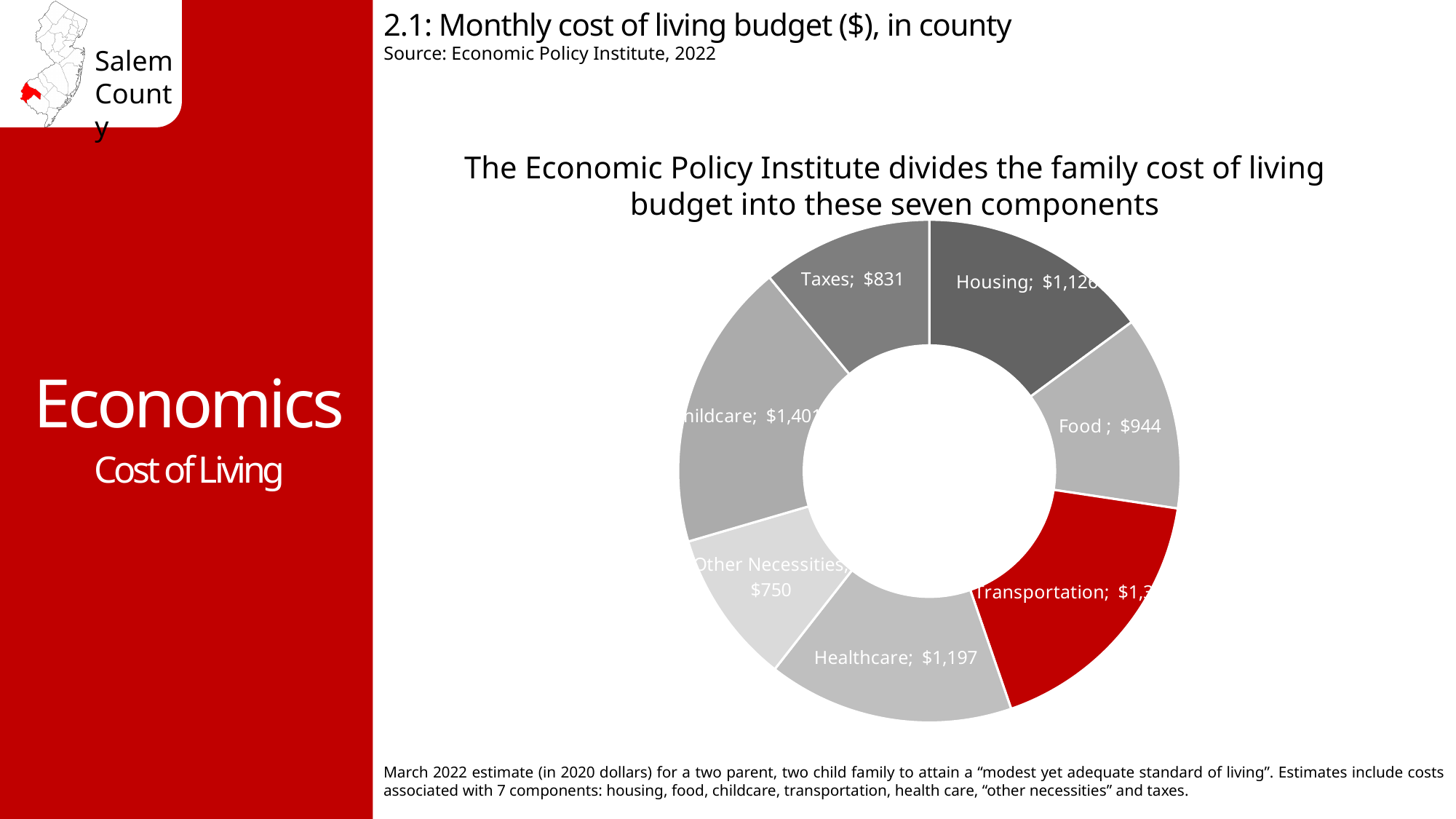
What is the difference between the Healthcare and Taxes monthly costs? $366 Which is larger, the monthly cost for Healthcare or for Food? Healthcare Which component's slice is coloured red in the chart? Transportation What is the monthly cost for Food in the chart? $944 Which is larger, the monthly cost for Taxes or for Other Necessities? Taxes What is the monthly cost for Healthcare in the chart? $1,197 What is the monthly cost for Other Necessities in the chart? $750 Which component has the lowest monthly cost in the chart? Other Necessities How many components are shown in the chart? 7 What is the monthly cost for Taxes in the chart? $831 What is the difference between the Food and Other Necessities monthly costs? $194 What kind of chart is shown on the slide? Doughnut (pie) chart